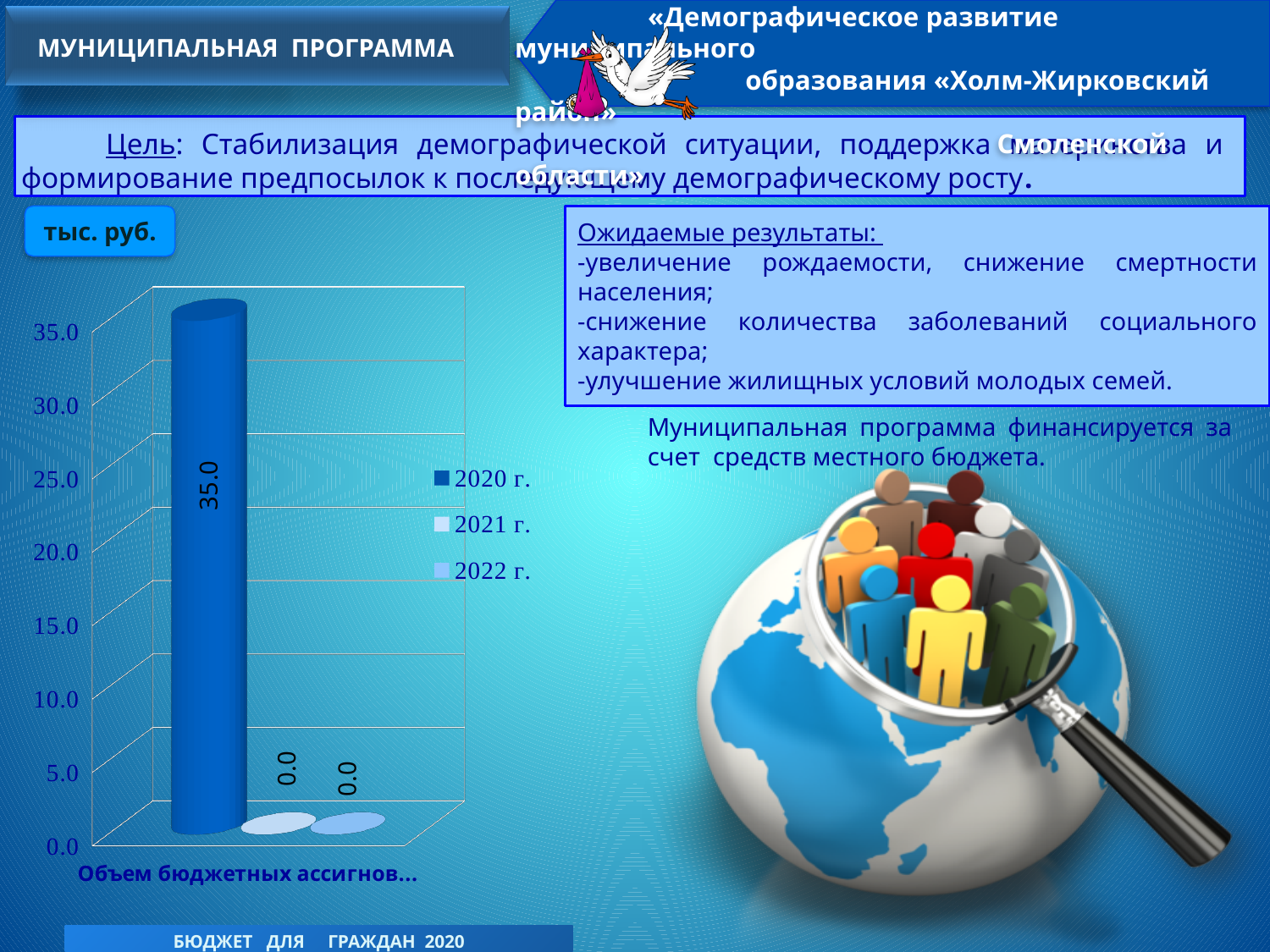
What kind of chart is shown on the slide? bar chart Which series has the highest value in the chart? 2020 г. What is the difference between the 2020 г. value and the 2021 г. value? 35.0 Which is larger, the value for 2020 г. or the value for 2022 г.? 2020 г. Is the value for 2020 г. greater or less than 30.0? greater What is the value for the 2021 г. series in the chart? 0.0 What is the value for the 2020 г. series in the chart? 35.0 Do the values fall or rise from 2020 г. to 2022 г.? fall What is the highest value shown on the chart's vertical axis? 35.0 What is the value for the 2022 г. series in the chart? 0.0 What unit is indicated for the chart values? тыс. руб. How many series does the chart legend list? 3